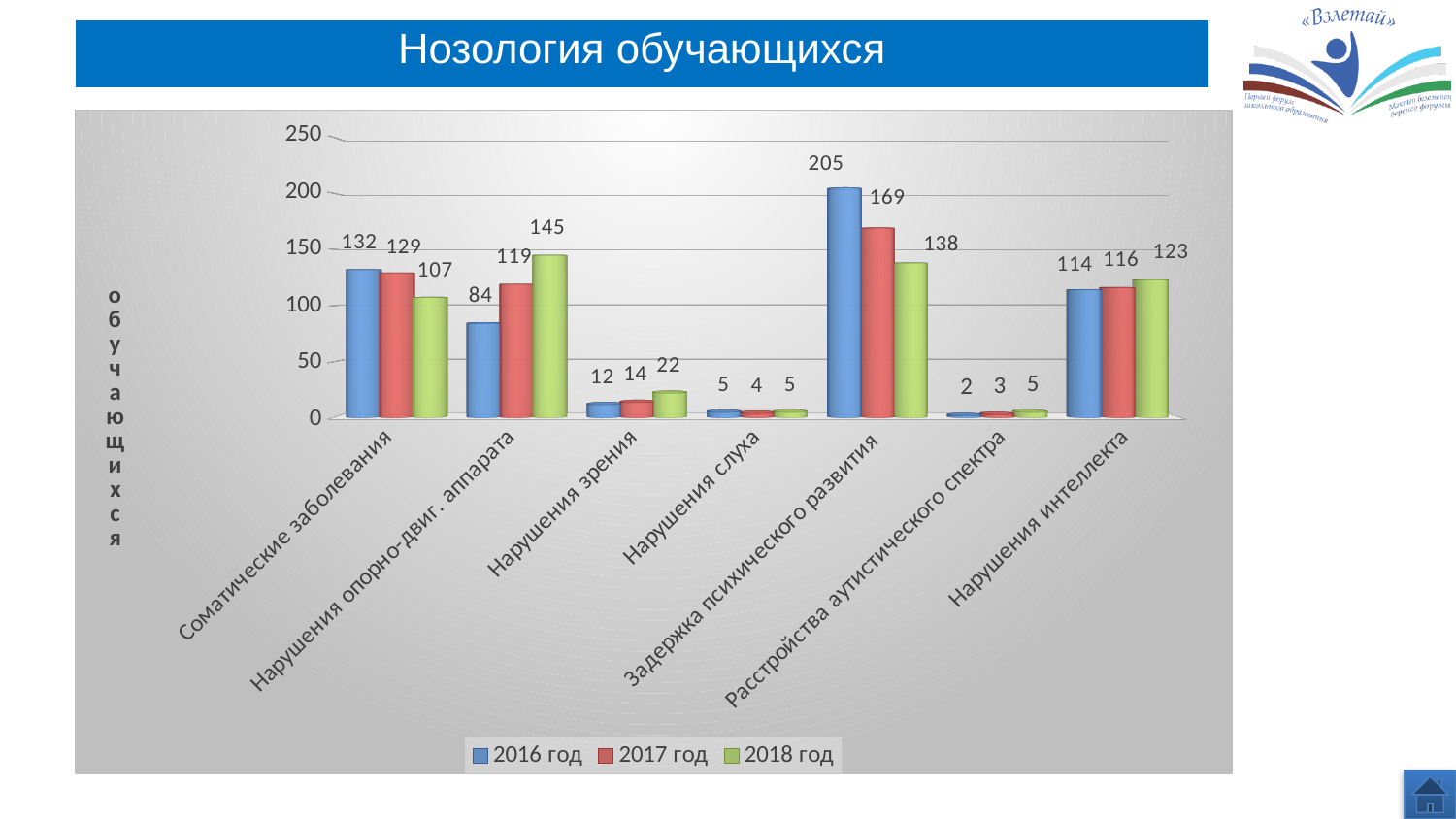
What is the difference between the 2018 год and 2016 год values for Нарушения опорно-двиг. аппарата? 61 Do the values for Нарушения интеллекта rise or fall from 2016 год to 2018 год? rise What is the difference between the 2016 год and 2018 год values for Задержка психического развития? 67 What is the value for Нарушения опорно-двиг. аппарата in 2018 год? 145 Which category has the lowest value in 2016 год? Расстройства аутистического спектра How many categories are shown on the x axis? 7 Which is larger for Соматические заболевания: the 2016 год value or the 2018 год value? 2016 год How many series does the legend list? 3 Which category has the highest value in 2016 год? Задержка психического развития What is the value for Задержка психического развития in 2016 год? 205 What kind of chart is shown on the slide? bar chart What is the value for Нарушения зрения in 2017 год? 14